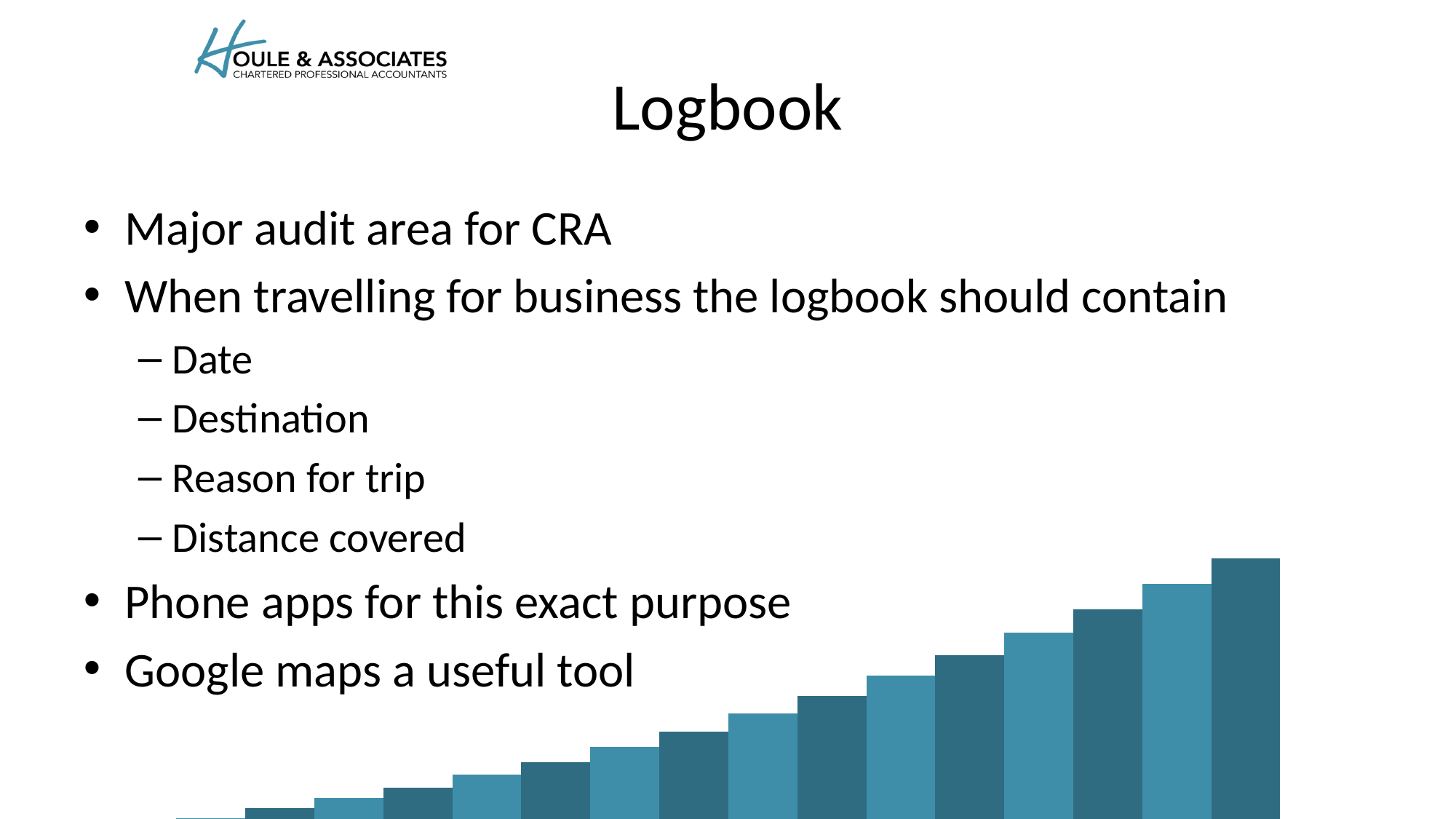
What kind of chart is shown at the bottom right of the slide? bar chart What colour are the bars in the chart at the bottom of the slide? alternating shades of teal blue Do the bars in the chart at the bottom of the slide rise or fall from left to right? rise Which bar in the chart at the bottom of the slide is the tallest, the leftmost or the rightmost? the rightmost Does the chart at the bottom of the slide show any axis labels or data labels? No